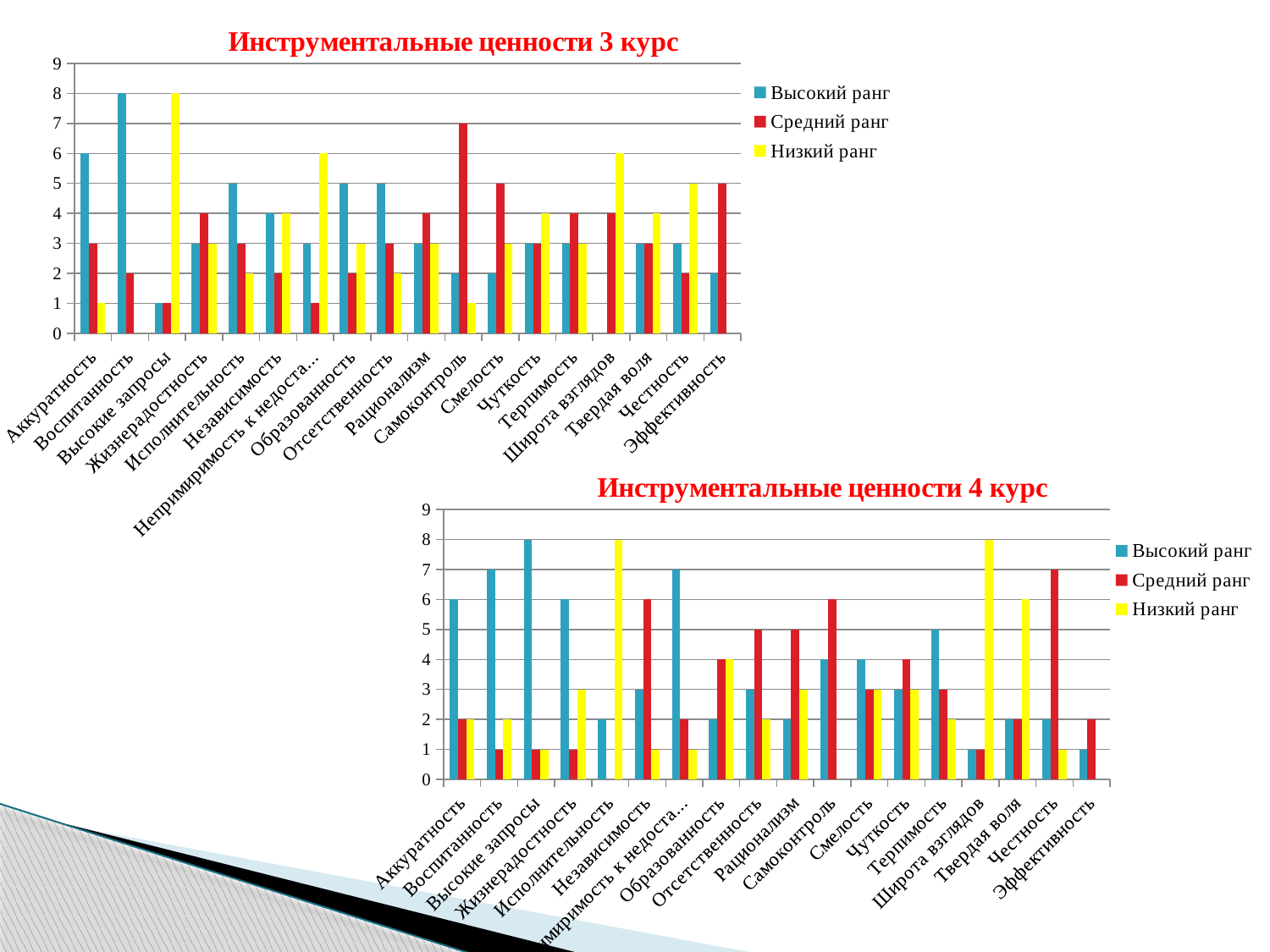
On the chart titled "Инструментальные ценности 3 курс", which category has the highest Низкий ранг value? Высокие запросы On the chart titled "Инструментальные ценности 4 курс", what is the value of Низкий ранг for Исполнительность? 8 On the chart titled "Инструментальные ценности 3 курс", what is the value of Высокий ранг for Воспитанность? 8 On the chart titled "Инструментальные ценности 4 курс", which category has the highest Высокий ранг value? Высокие запросы On the chart titled "Инструментальные ценности 4 курс", how many categories are shown on the x axis? 18 On the chart titled "Инструментальные ценности 3 курс", how many series does the legend list? 3 On the chart titled "Инструментальные ценности 4 курс", what kind of chart is it? Bar chart On the chart titled "Инструментальные ценности 3 курс", what is the value of Средний ранг for Самоконтроль? 7 On the chart titled "Инструментальные ценности 3 курс", which is larger for Смелость: Высокий ранг or Средний ранг? Средний ранг On the chart titled "Инструментальные ценности 4 курс", which colour represents Низкий ранг in the legend? Yellow On the chart titled "Инструментальные ценности 3 курс", what is the difference between the Высокий ранг value for Аккуратность and the Высокий ранг value for Высокие запросы? 5 On the chart titled "Инструментальные ценности 4 курс", what is the value of Средний ранг for Честность? 7